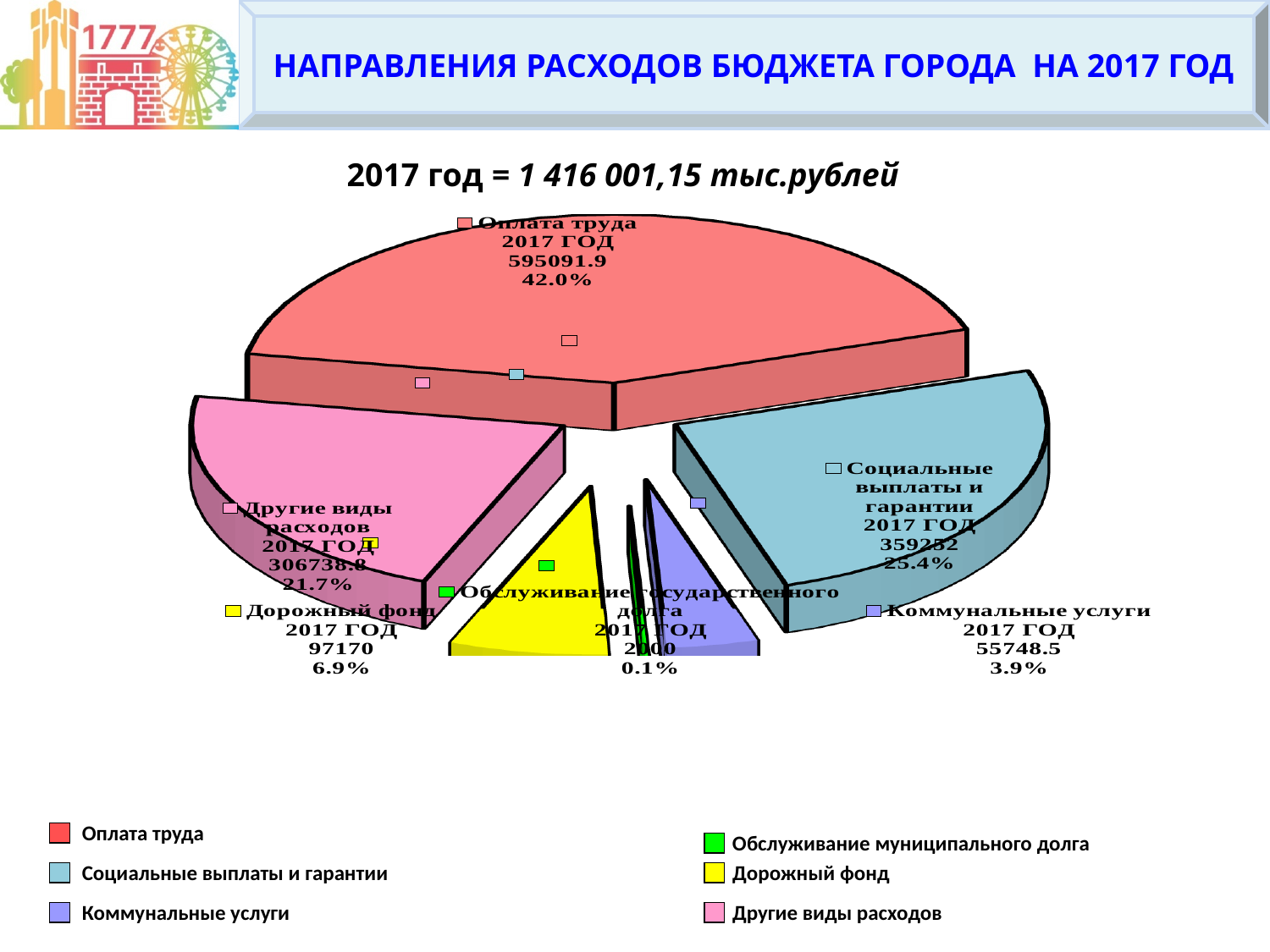
What is the value for Оплата труда? 595091.9 What is the value for Дорожный фонд? 97170 Which category has the largest slice of the pie? Оплата труда What share of the pie does Социальные выплаты и гарантии represent? 25.4% What share of the pie does Оплата труда represent? 42.0% How many entries does the legend list? 6 What is the value for Коммунальные услуги? 55748.5 Which category has the smallest slice of the pie? Обслуживание государственного долга Which is larger, Дорожный фонд or Коммунальные услуги? Дорожный фонд What is the value for Другие виды расходов? 306738.8 What kind of chart is shown on the slide? pie chart What share of the pie does Обслуживание государственного долга represent? 0.1%